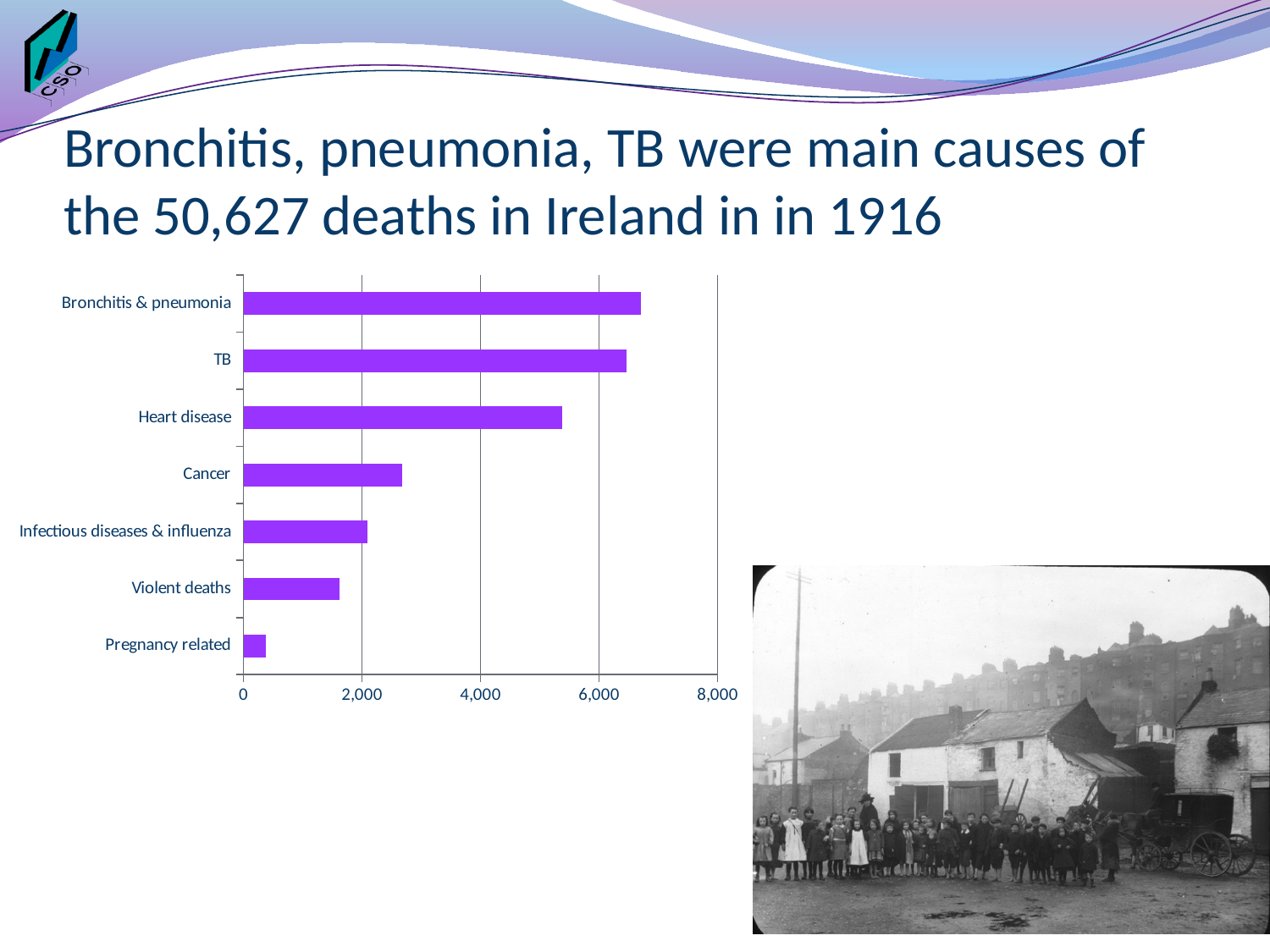
Is the value for Heart disease greater or less than 6,000? less Which cause of death has the highest number of deaths on the chart? Bronchitis & pneumonia Which cause of death has the lowest number of deaths on the chart? Pregnancy related How many causes of death are listed on the chart? 7 What is the highest value shown on the horizontal axis of the chart? 8,000 What kind of chart is shown on the slide? bar chart Which has more deaths, Heart disease or Cancer? Heart disease Is the value for Bronchitis & pneumonia greater or less than 6,000? greater Is the value for Heart disease greater or less than 4,000? greater Do the bar values increase or decrease going from the top category to the bottom category? decrease